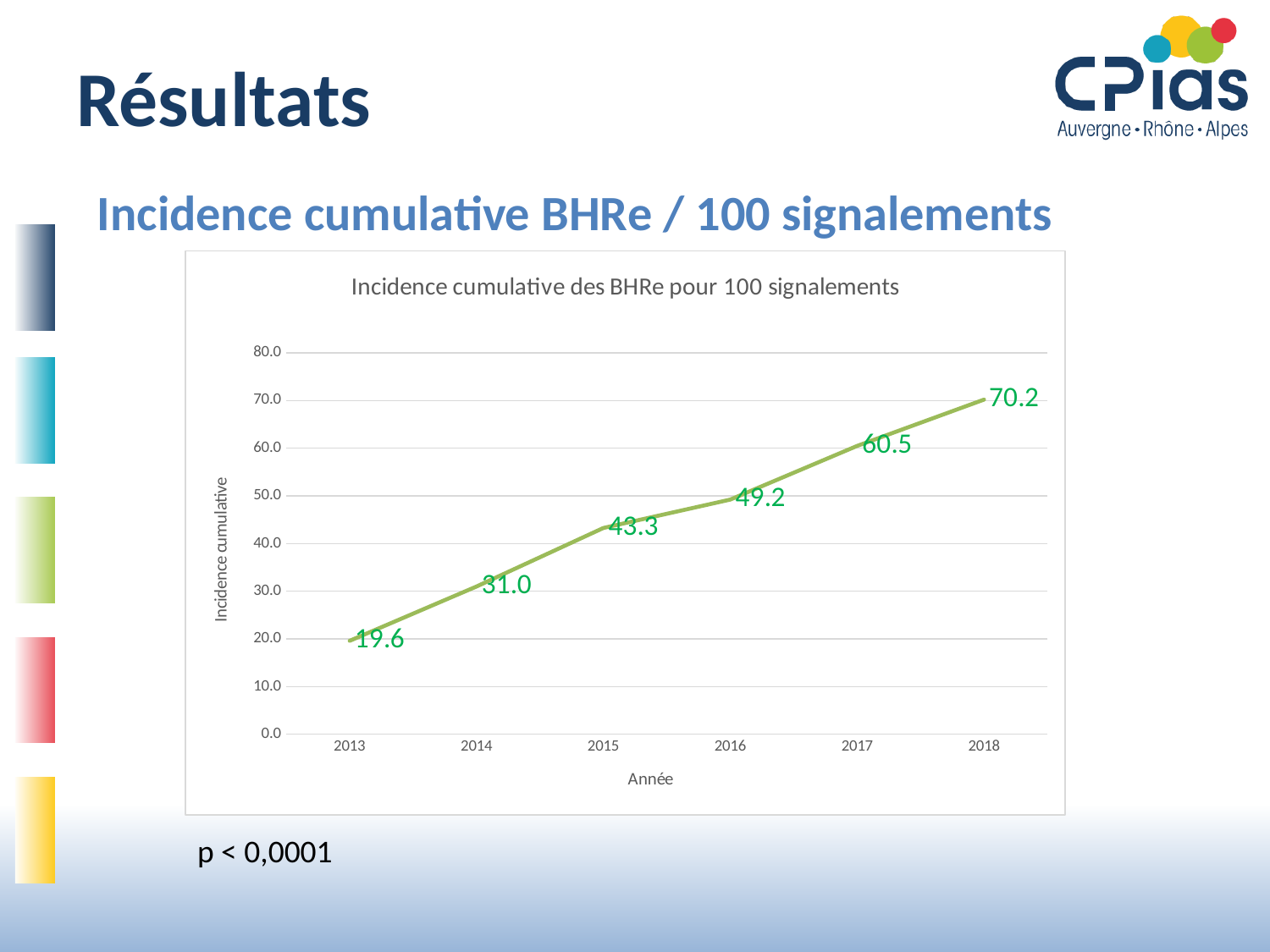
What is the difference between the values for 2018 and 2013? 50.6 What is the difference between the values for 2015 and 2014? 12.3 Is the value for 2017 greater or less than 50.0? greater What kind of chart is shown on the slide? line chart Do the values rise or fall from 2013 to 2018? rise How many years are plotted on the chart? 6 Which year has the highest cumulative incidence? 2018 Which is larger, the value for 2017 or the value for 2016? 2017 What is the cumulative incidence value for 2016? 49.2 What is the cumulative incidence value for 2013? 19.6 What is the cumulative incidence value for 2018? 70.2 Which year has the lowest cumulative incidence? 2013